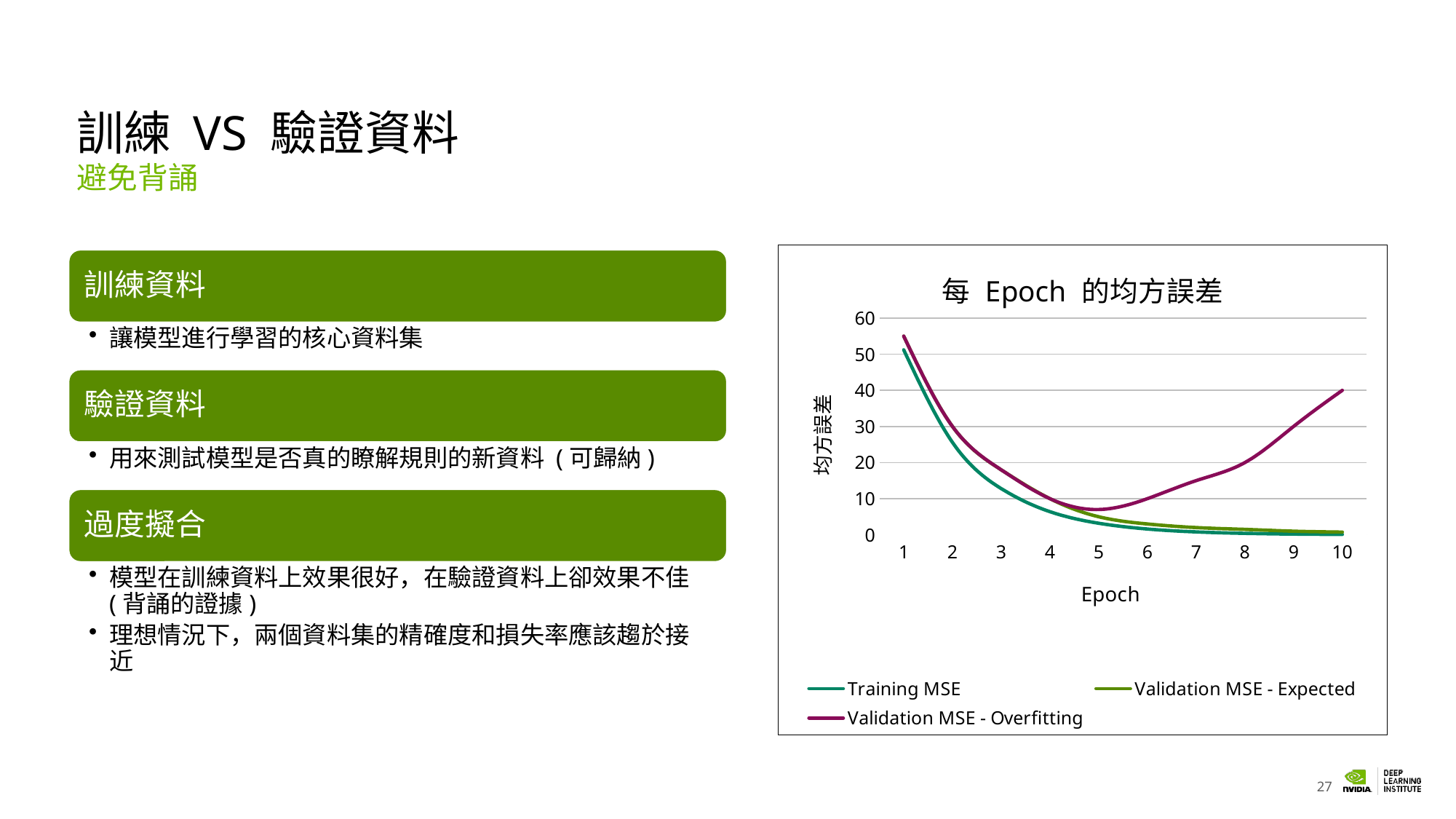
What is the title of the chart? 每 Epoch 的均方誤差 What is the label of the x axis? Epoch How many epochs are plotted along the x axis? 10 Is the value of Training MSE at epoch 1 greater or less than 40? greater What kind of chart is shown on the slide? line chart Which series has the highest value at epoch 10? Validation MSE - Overfitting How many series does the chart legend list? 3 Does the Validation MSE - Overfitting line rise or fall from epoch 5 to epoch 10? rise At epoch 10, which is larger: Training MSE or Validation MSE - Overfitting? Validation MSE - Overfitting Does the Training MSE line rise or fall from epoch 1 to epoch 10? fall Is the value of Training MSE at epoch 10 greater or less than 10? less Is the value of Validation MSE - Overfitting at epoch 10 greater or less than 30? greater